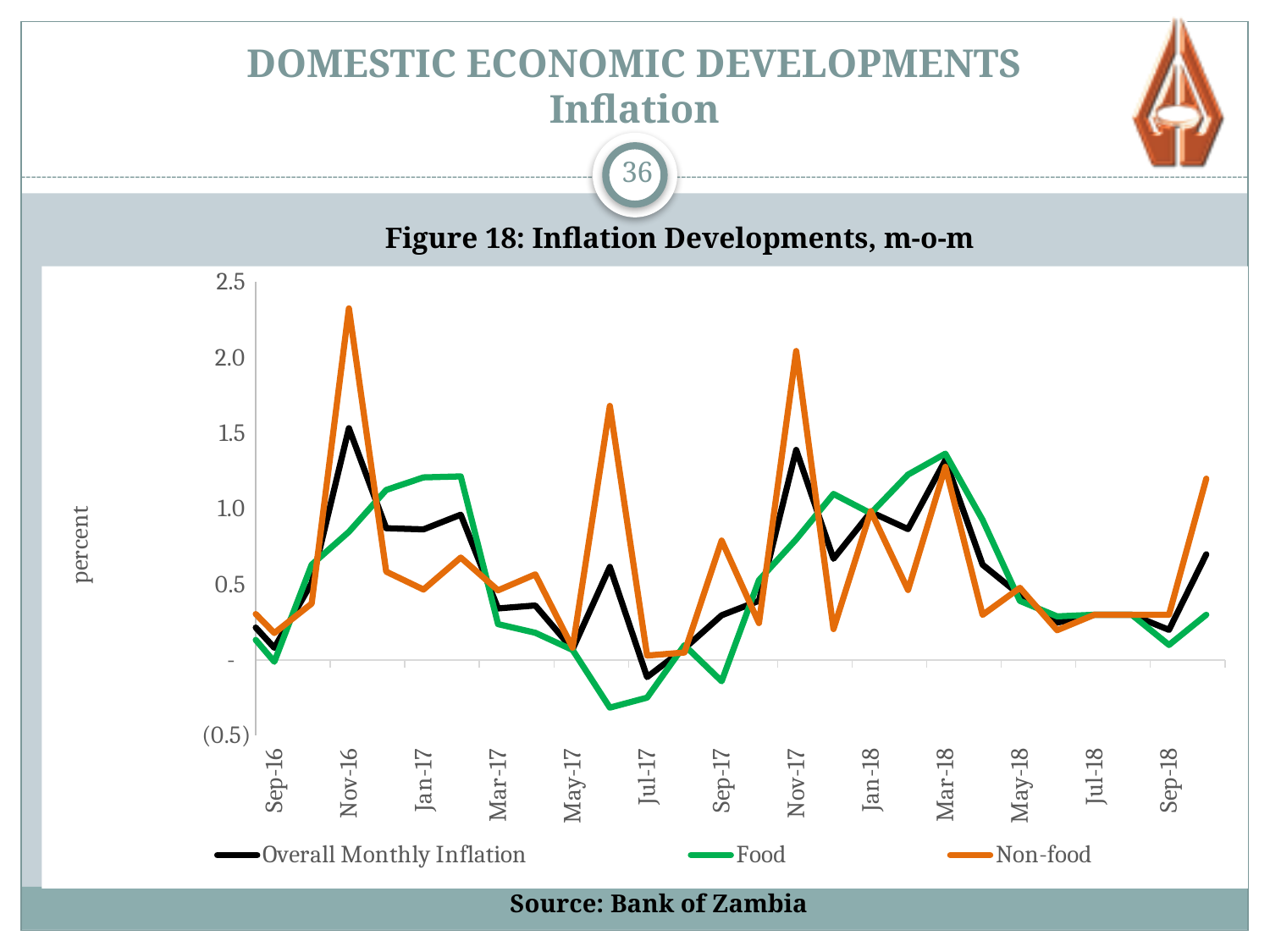
Which series reaches the highest value anywhere on the chart? Non-food How many series does the legend of Figure 18 list? 3 What is the title of the chart on the slide? Figure 18: Inflation Developments, m-o-m What kind of chart is shown in Figure 18? Line chart What label is shown on the vertical axis of the chart? percent Does the Overall Monthly Inflation series rise or fall from Mar-18 to Jul-18? fall Is the Non-food value at Nov-16 greater or less than 2.0? greater Which series reaches the lowest value anywhere on the chart? Food At Jan-17, which is larger: the Food value or the Non-food value? Food Is the lowest value of the Food series greater or less than 0? less Is the Overall Monthly Inflation value at Nov-17 greater or less than 1.0? greater At Nov-16, which is larger: the Non-food value or the Food value? Non-food